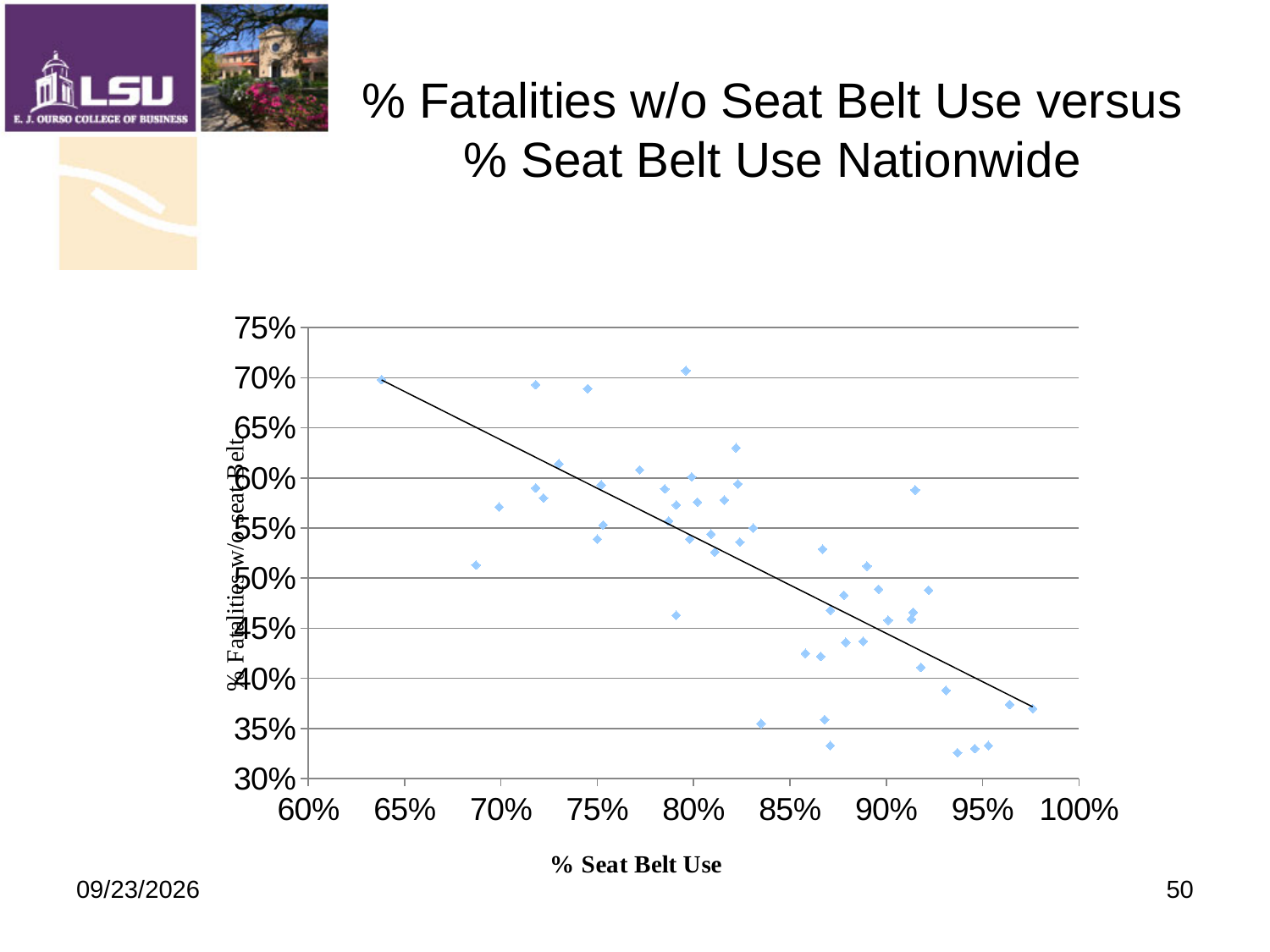
As % Seat Belt Use increases along the x axis, do the plotted fatality percentages generally rise or fall? Fall Is the lowest plotted fatality percentage greater or less than 35%? less What is the highest value shown on the x axis? 100% Is the seat belt use value of the rightmost point greater or less than 95%? greater What is the lowest value shown on the y axis? 30% What is the label of the x axis? % Seat Belt Use What kind of chart is shown on the slide? Scatter plot Is the seat belt use value of the leftmost point greater or less than 65%? less Does the fitted line slope upward or downward from left to right? Downward